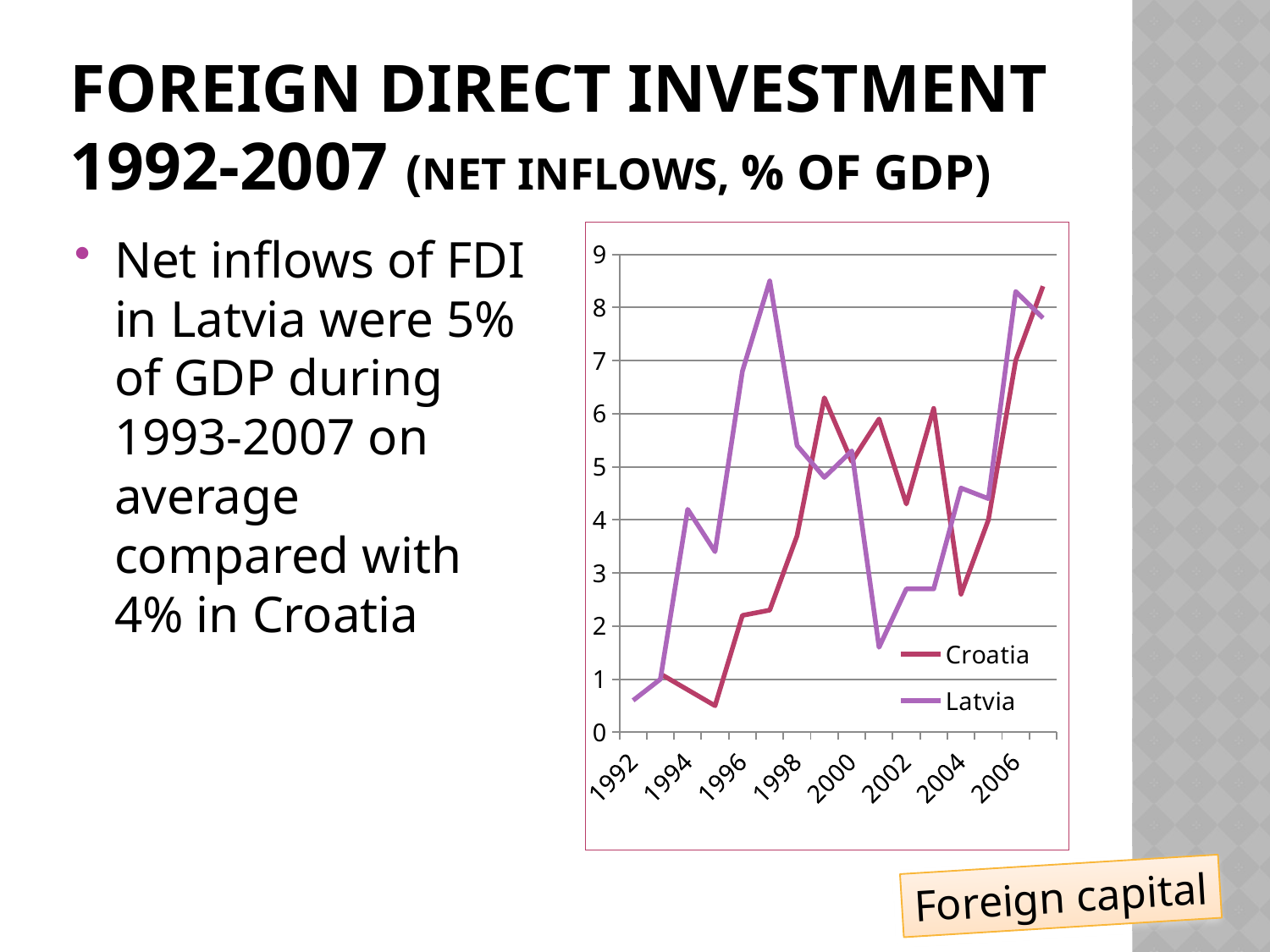
In which year does the Croatia line reach its highest value? 2007 In 1999, which country has the higher value, Croatia or Latvia? Croatia Is the value for Latvia in 1997 greater or less than 7? greater How many series does the chart's legend list? 2 What kind of chart is shown on the slide? line chart In 1997, which country has the higher value, Croatia or Latvia? Latvia Is the value for Croatia in 1995 greater or less than 1? less In which year does the Croatia line have its lowest value? 1995 Does the Croatia line rise or fall between 2004 and 2007? rise What is the highest value shown on the chart's vertical axis? 9 Which two countries are listed in the chart's legend? Croatia and Latvia Is the value for Latvia in 2001 greater or less than 2? less